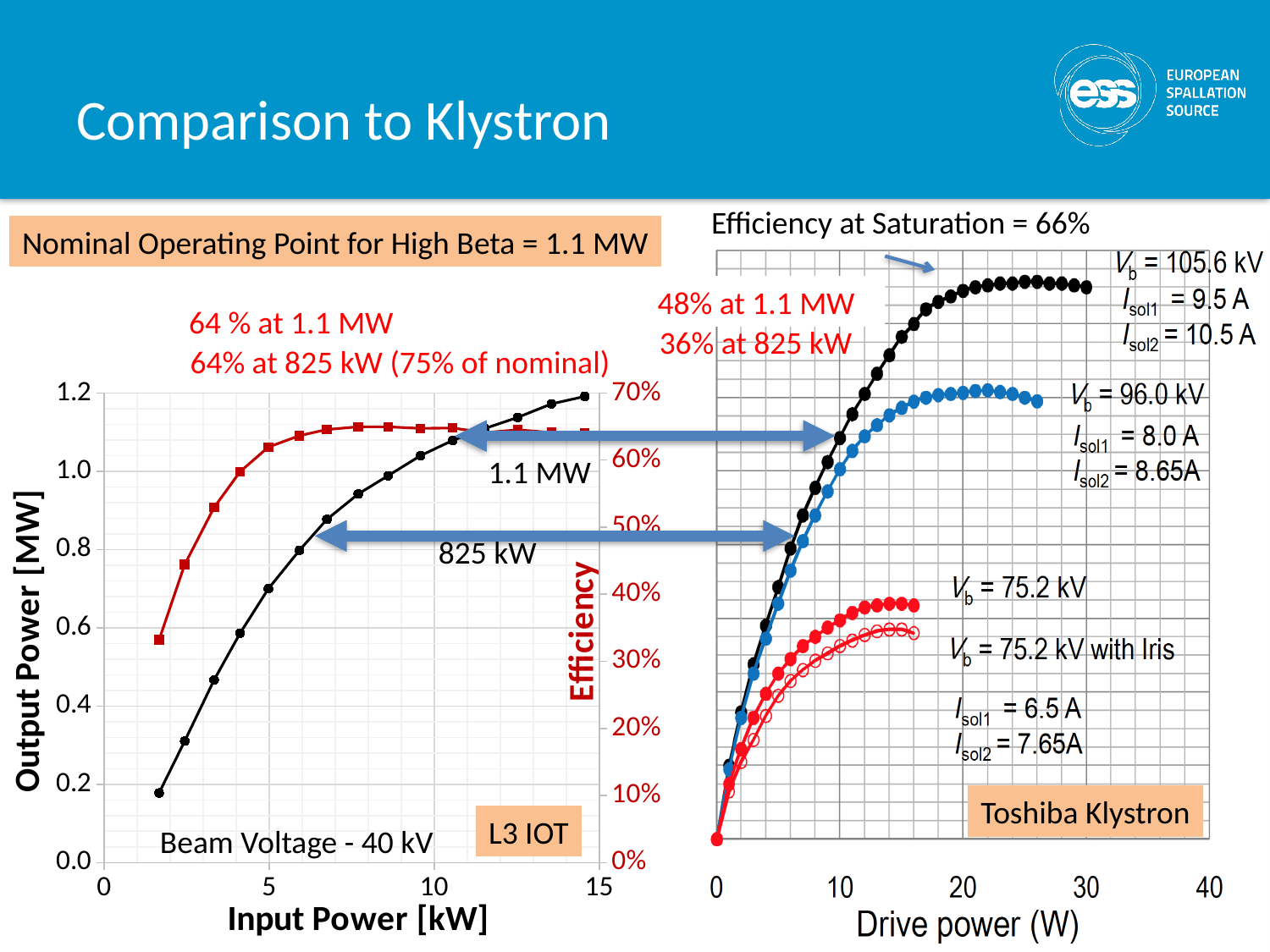
What is the efficiency at saturation stated for the Toshiba Klystron chart? 66% On the L3 IOT chart, does the output power rise or fall as input power increases? rises What kind of chart is the L3 IOT chart on the left of the slide? line chart According to the slide, what is the efficiency of the Toshiba Klystron at 825 kW? 36% On the Toshiba Klystron chart, which beam voltage curve reaches the highest output? Vb = 105.6 kV On the Toshiba Klystron chart, what is the label of the x axis? Drive power (W) On the L3 IOT chart, is the output power at an input power of 5 kW greater or less than 1.0 MW? less What is the difference between the L3 IOT efficiency and the Toshiba Klystron efficiency at 1.1 MW? 16% On the L3 IOT chart, what is the label of the x axis? Input Power [kW] According to the slide, what is the efficiency of the Toshiba Klystron at 1.1 MW? 48% According to the slide, what is the efficiency of the L3 IOT at 1.1 MW? 64 % At 825 kW, which has the higher efficiency, the L3 IOT or the Toshiba Klystron? L3 IOT